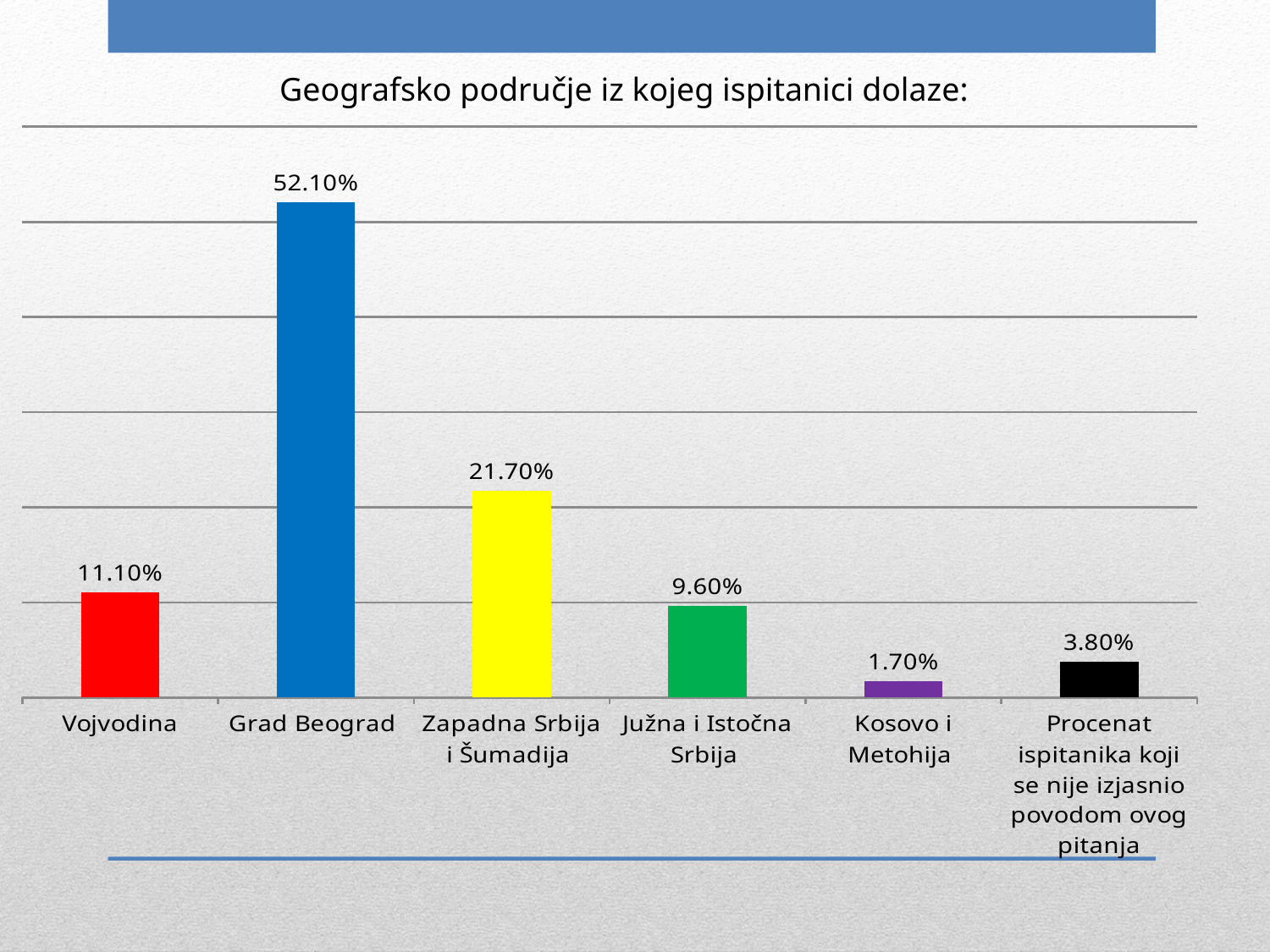
What is the value for Kosovo i Metohija? 1.70% What is the value for Zapadna Srbija i Šumadija? 21.70% Which category has the highest value? Grad Beograd What is the value for Grad Beograd? 52.10% Which is larger, the value for Vojvodina or the value for Južna i Istočna Srbija? Vojvodina What is the value for Vojvodina? 11.10% How many categories are shown in the chart? 6 What is the value for Južna i Istočna Srbija? 9.60% Which category has the lowest value? Kosovo i Metohija What is the difference between the values for Grad Beograd and Zapadna Srbija i Šumadija? 30.40% What kind of chart is shown on the slide? Bar chart What is the title of the chart? Geografsko područje iz kojeg ispitanici dolaze: